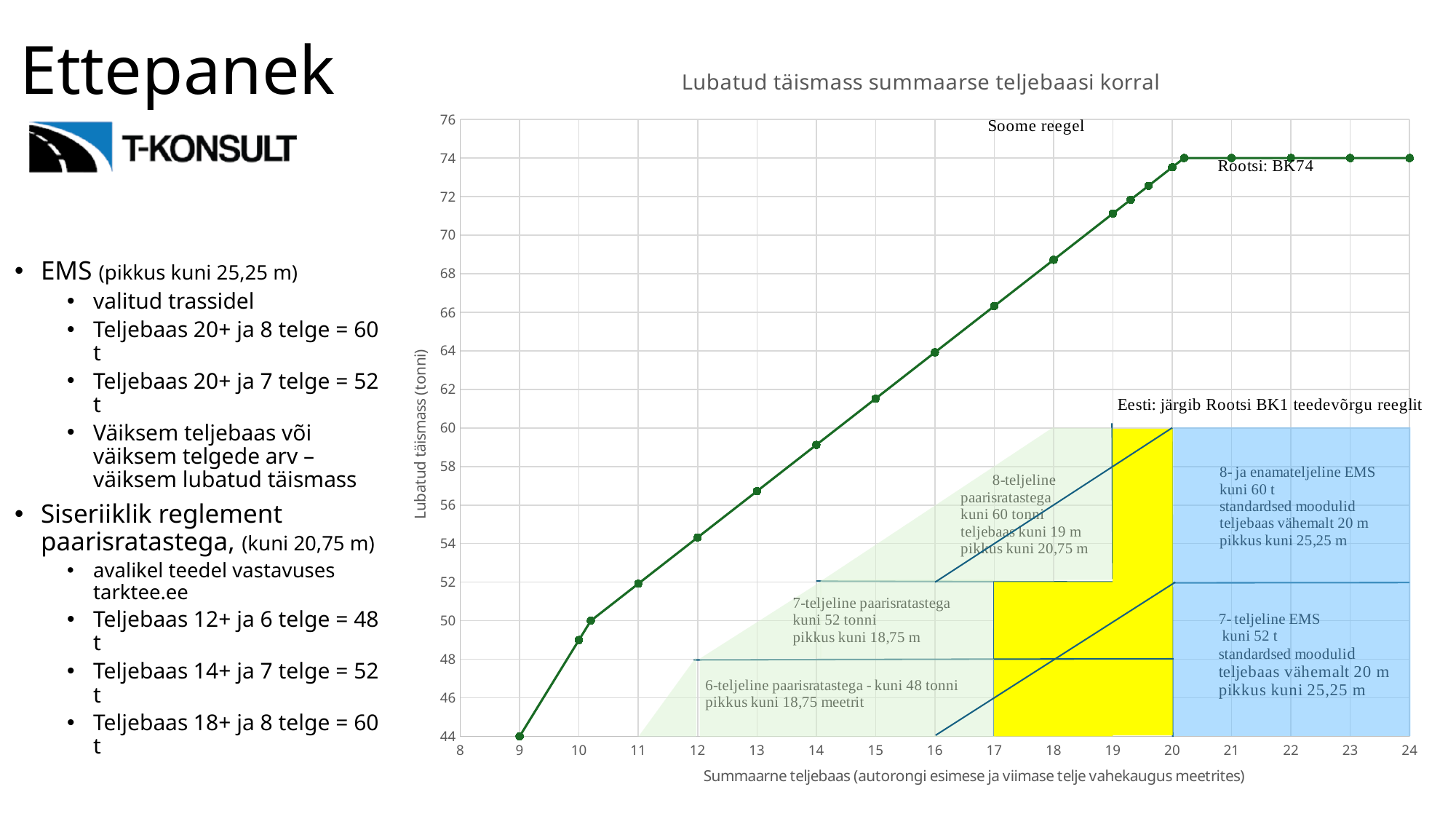
What is the label of the vertical axis of the chart? Lubatud täismass (tonni) What is the plotted value (tonni) at a summaarne teljebaas of 24 m? 74 What is the lowest value on the plotted line? 44 What is the title of the chart? Lubatud täismass summaarse teljebaasi korral What kind of chart is shown on the slide? line chart Is the plotted value at 18 m greater or less than 70? less Is the plotted value at 14 m greater or less than 58? greater Which has a larger plotted value: 12 m or 18 m of summaarne teljebaas? 18 m What is the highest value reached by the plotted line? 74 Is the plotted value at 13 m greater or less than 56? greater What is the plotted value (tonni) at a summaarne teljebaas of 9 m? 44 Does the plotted line rise or fall as the summaarne teljebaas increases from 9 m to 20 m? rise